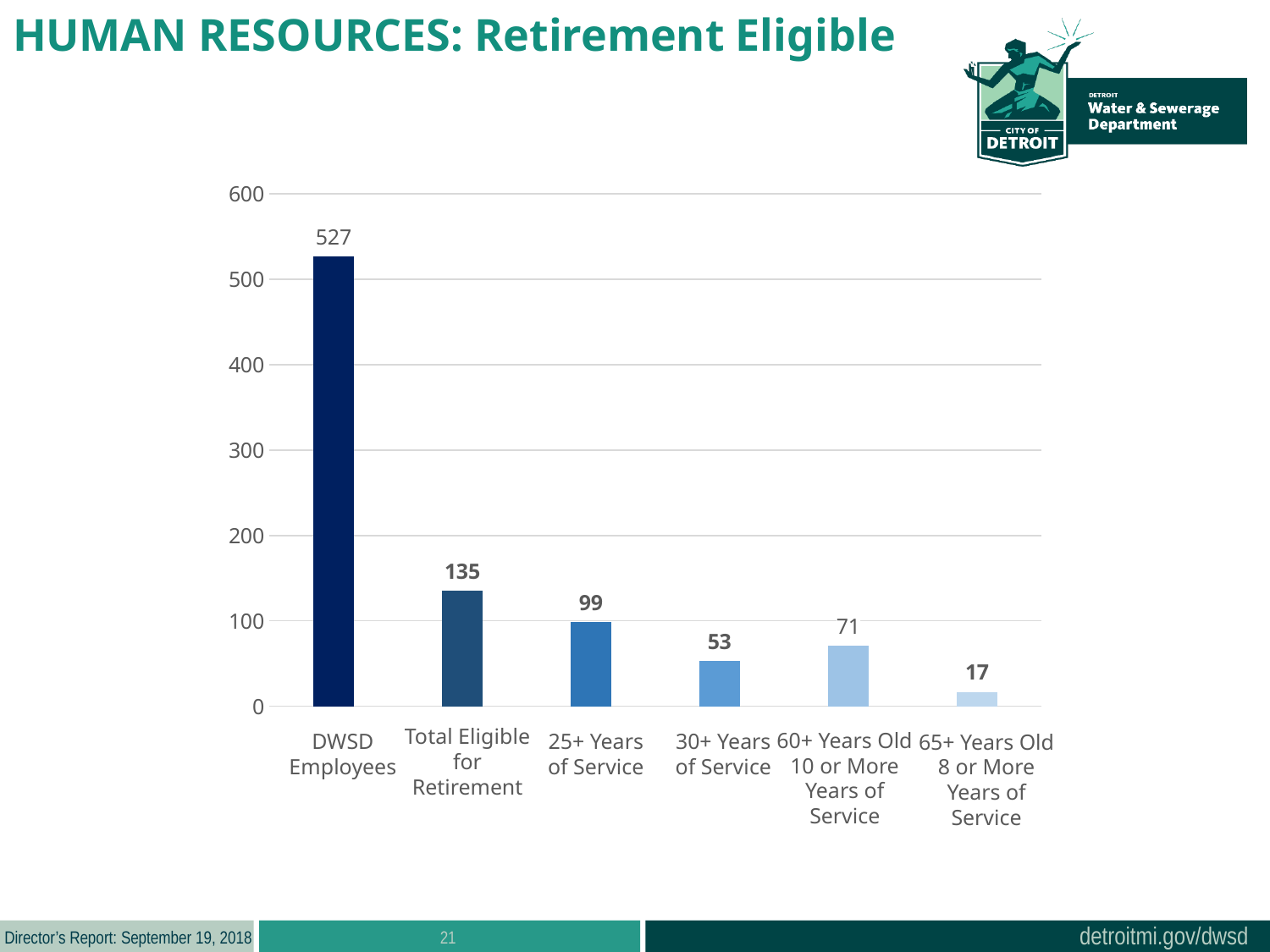
What is the difference between the values for DWSD Employees and Total Eligible for Retirement? 392 Which is larger, the value for 30+ Years of Service or the value for 60+ Years Old 10 or More Years of Service? 60+ Years Old 10 or More Years of Service What kind of chart is shown on the slide? bar chart Which category has the highest value? DWSD Employees How many categories are shown on the chart? 6 Is the value for Total Eligible for Retirement greater or less than 100? greater Which category has the lowest value? 65+ Years Old 8 or More Years of Service What is the value for Total Eligible for Retirement? 135 What is the difference between the values for 60+ Years Old 10 or More Years of Service and 30+ Years of Service? 18 What is the value for DWSD Employees? 527 What is the value for 25+ Years of Service? 99 What is the value for 65+ Years Old 8 or More Years of Service? 17